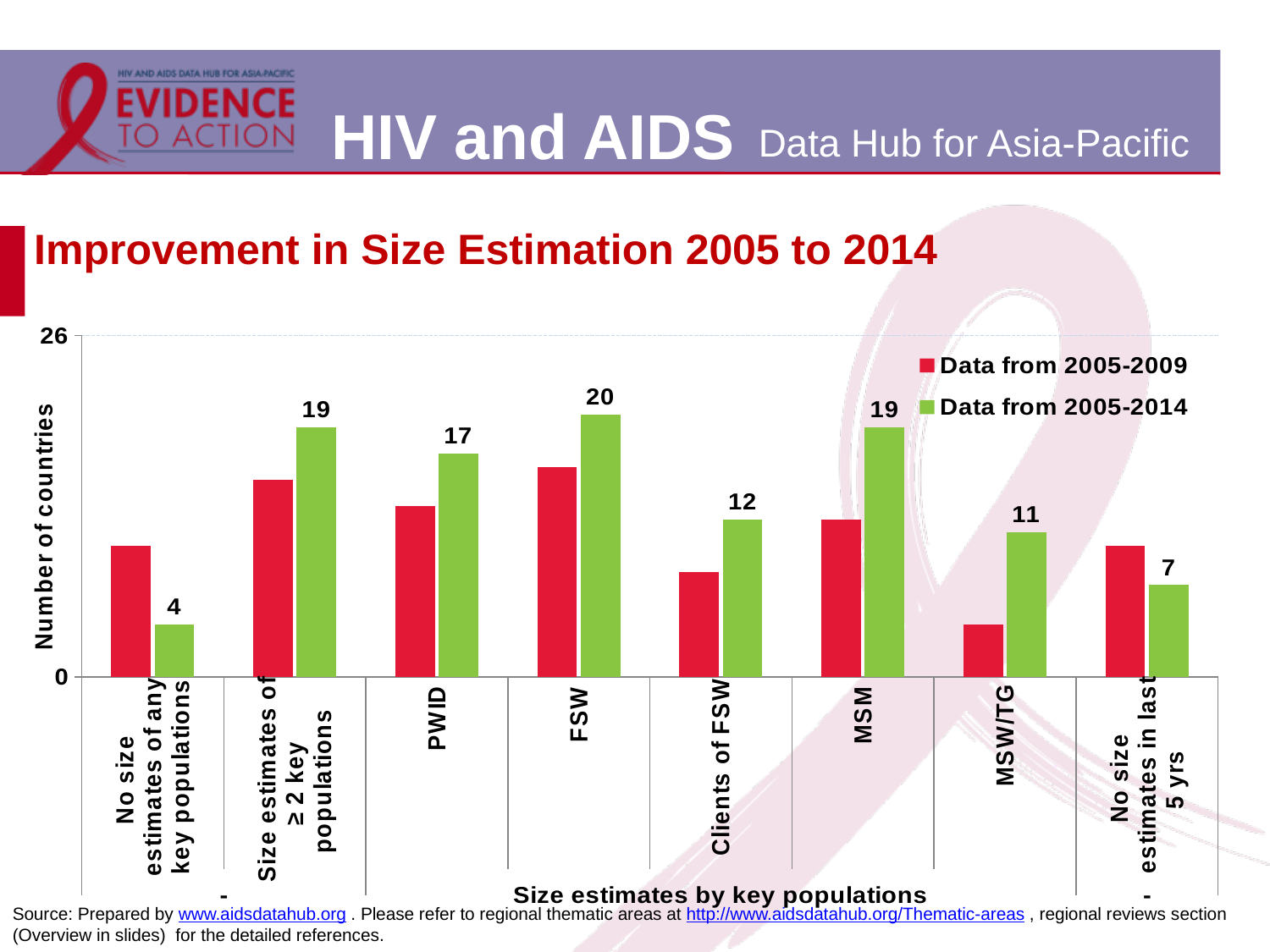
What is the value for MSW/TG in the 'Data from 2005-2014' series? 11 Which category has the lowest value in the 'Data from 2005-2014' series? No size estimates of any key populations What is the label of the y axis? Number of countries What is the difference between the 'Data from 2005-2014' values for FSW and Clients of FSW? 8 What is the value for 'No size estimates of any key populations' in the 'Data from 2005-2014' series? 4 How many series does the legend list? 2 What kind of chart is shown on the slide? bar chart Which category has the highest value in the 'Data from 2005-2014' series? FSW What is the value for PWID in the 'Data from 2005-2014' series? 17 What is the value for FSW in the 'Data from 2005-2014' series? 20 For 'No size estimates of any key populations', which series has the larger value: 'Data from 2005-2009' or 'Data from 2005-2014'? Data from 2005-2009 How many key population categories are shown on the x axis? 8